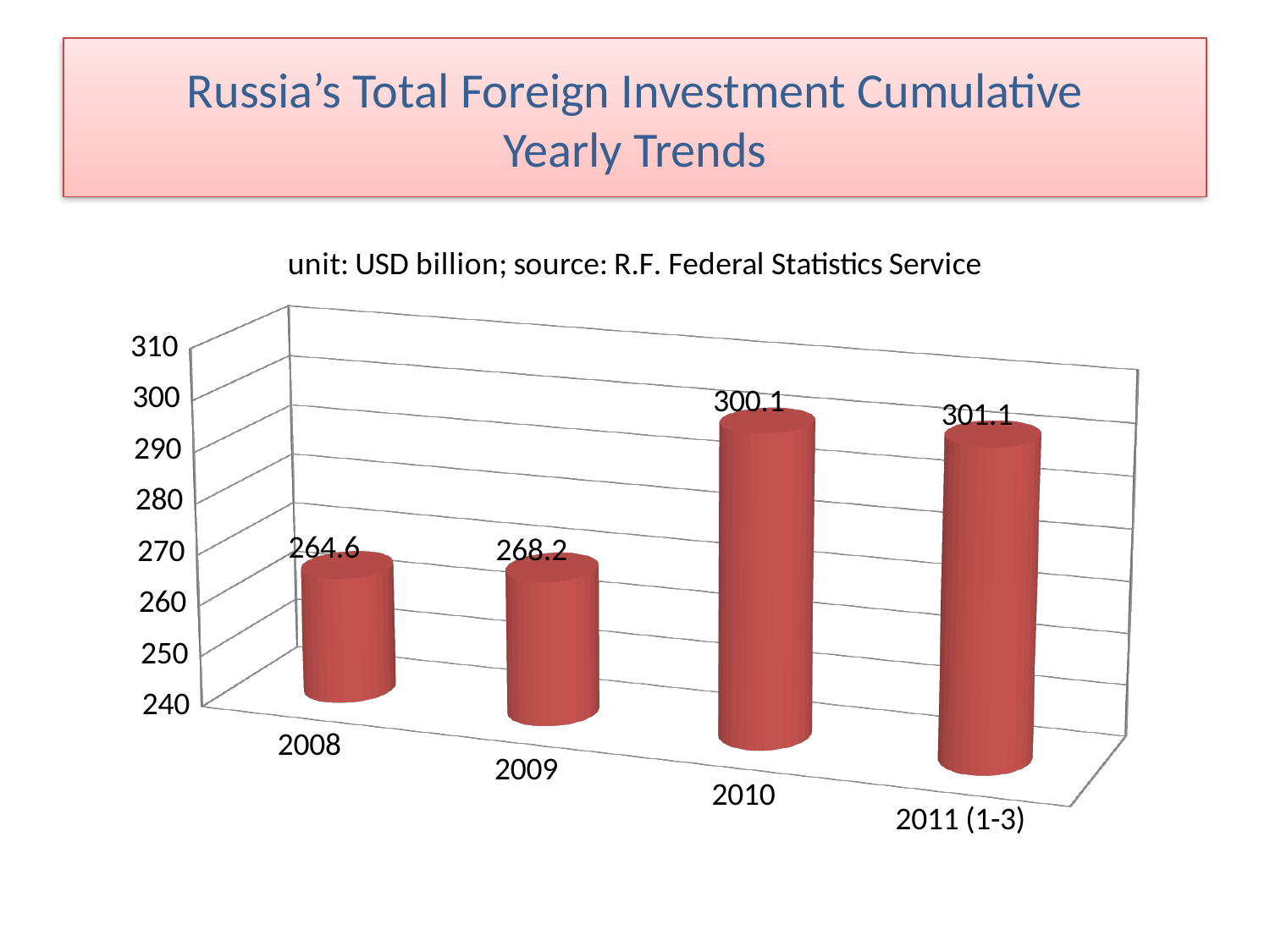
What is the difference between the values for 2009 and 2008? 3.6 What kind of chart is shown on the slide? bar chart Do the values rise or fall from 2008 to 2011 (1-3)? rise Which category has the lowest value? 2008 What is the value for 2009? 268.2 What is the value for 2008? 264.6 What is the value for 2011 (1-3)? 301.1 What is the value for 2010? 300.1 How many categories are shown on the x axis? 4 Which category has the highest value? 2011 (1-3) Which is larger, the value for 2010 or the value for 2008? 2010 What is the difference between the values for 2010 and 2009? 31.9